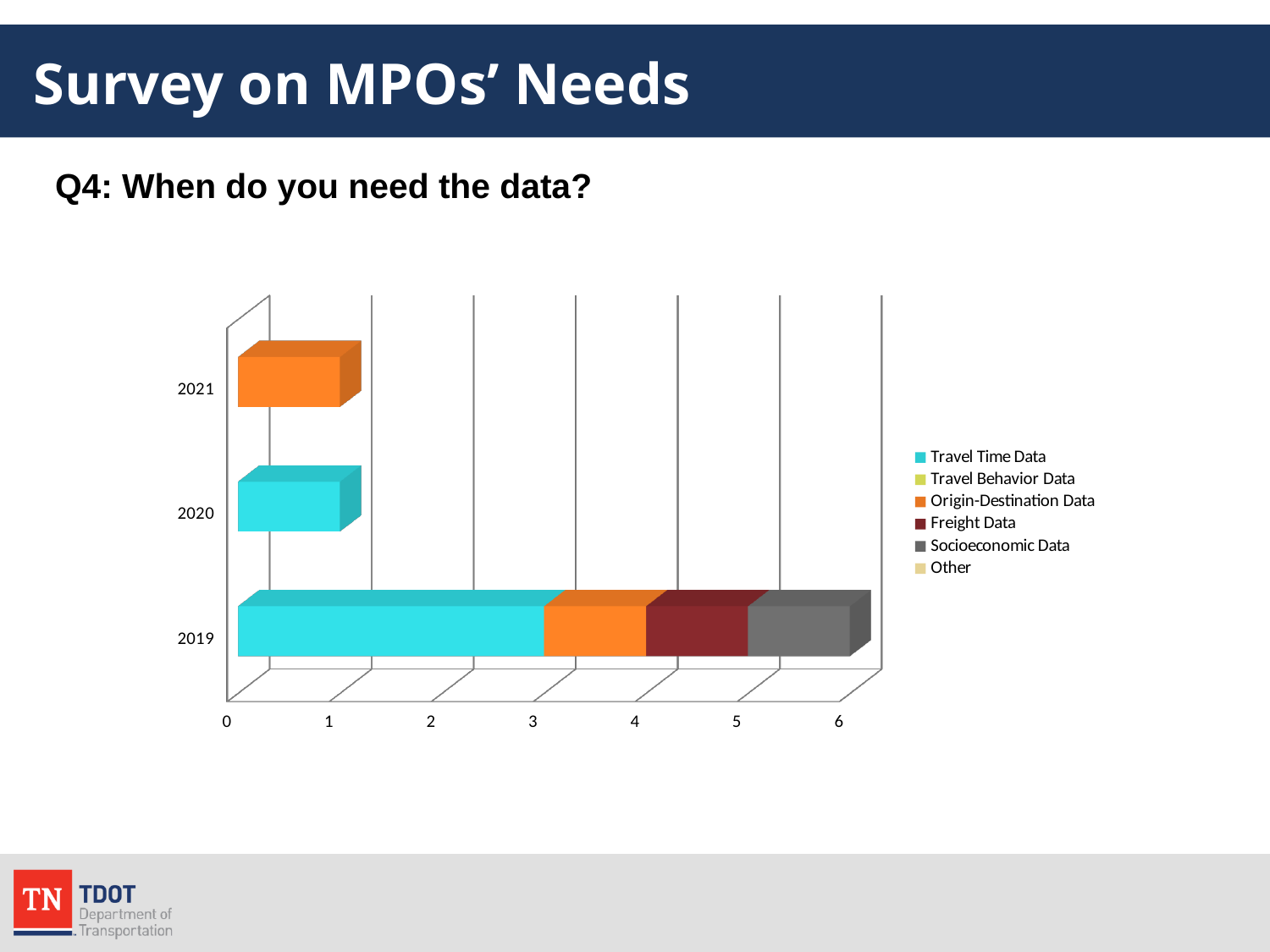
What kind of chart is shown on the slide? bar chart How many year categories are shown on the chart? 3 Which year has the longest total bar? 2019 Which is larger, the total bar for 2019 or the bar for 2020? 2019 Is the value for 2021 greater or less than 3? less What question does the chart address, as stated above it? Q4: When do you need the data? How many series does the legend list? 6 Which series appears in the 2020 bar? Travel Time Data Which series appears in the 2021 bar? Origin-Destination Data Is the total value for 2019 greater or less than 4? greater Is the value for 2020 greater or less than 2? less Which legend entry is shown in dark red? Freight Data